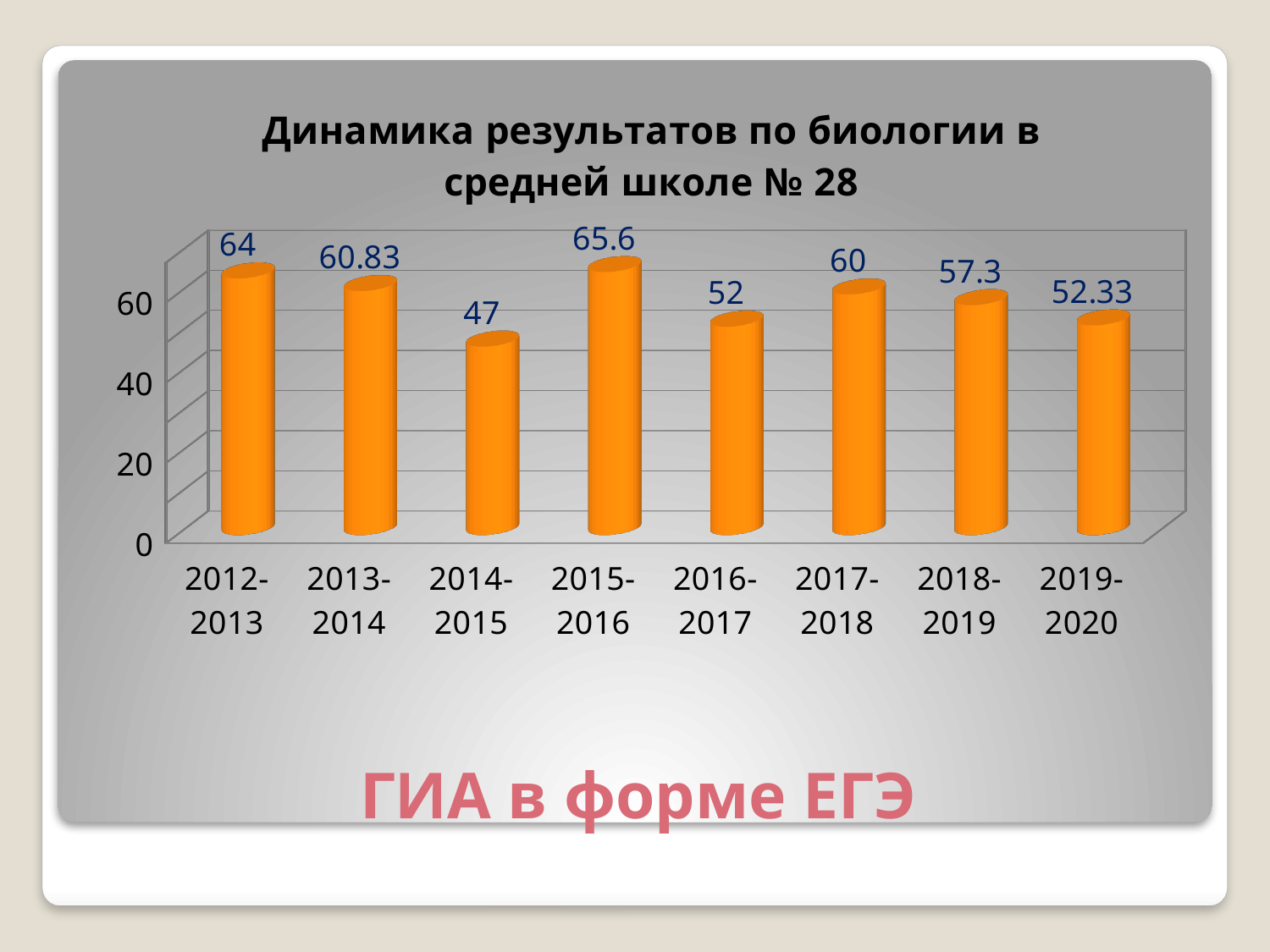
What is the value for 2018-2019? 57.3 What is the title of the chart? Динамика результатов по биологии в средней школе № 28 What is the difference between the values for 2015-2016 and 2014-2015? 18.6 How many academic years are shown on the chart? 8 Is the value for 2016-2017 greater or less than 60? less Which year has the highest value? 2015-2016 What is the value for 2019-2020? 52.33 Which year has the lowest value? 2014-2015 What is the value for 2012-2013? 64 What kind of chart is shown on the slide? bar chart What is the value for 2015-2016? 65.6 Which is larger, the value for 2013-2014 or the value for 2017-2018? 2013-2014